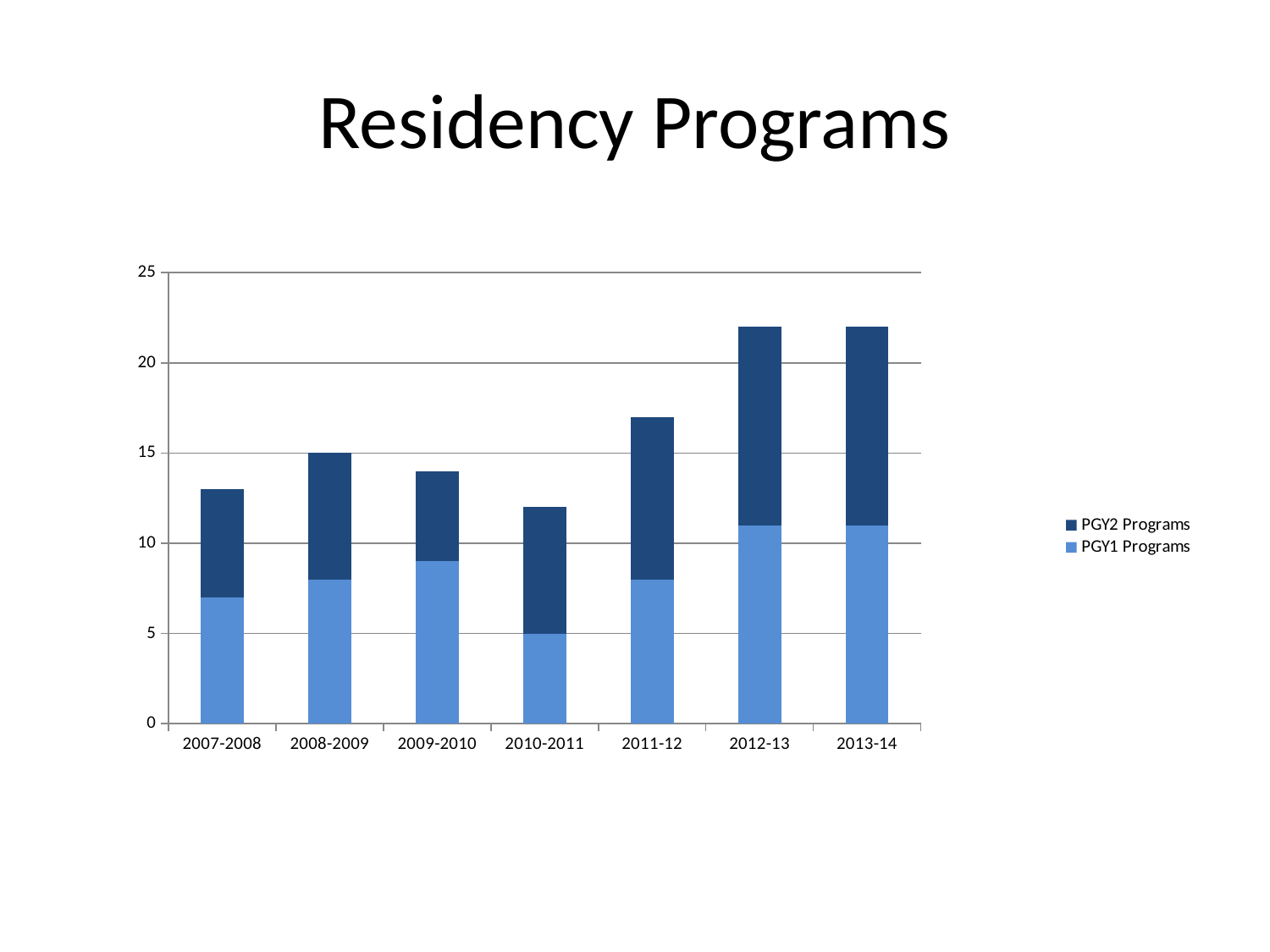
Is the total height of the 2011-12 bar greater or less than 15? greater Is the value for PGY1 Programs in 2009-2010 greater or less than 10? less What is the title of the chart? Residency Programs What kind of chart is shown on the slide? Stacked bar chart Which has the larger total bar, 2011-12 or 2008-2009? 2011-12 Does the total bar height rise or fall from 2010-2011 to 2013-14? rise Is the total height of the 2012-13 bar greater or less than 20? greater How many series does the legend list? 2 Which year has the lowest value for PGY1 Programs? 2010-2011 How many academic years are shown on the x axis? 7 Which series is shown in the darker blue colour? PGY2 Programs